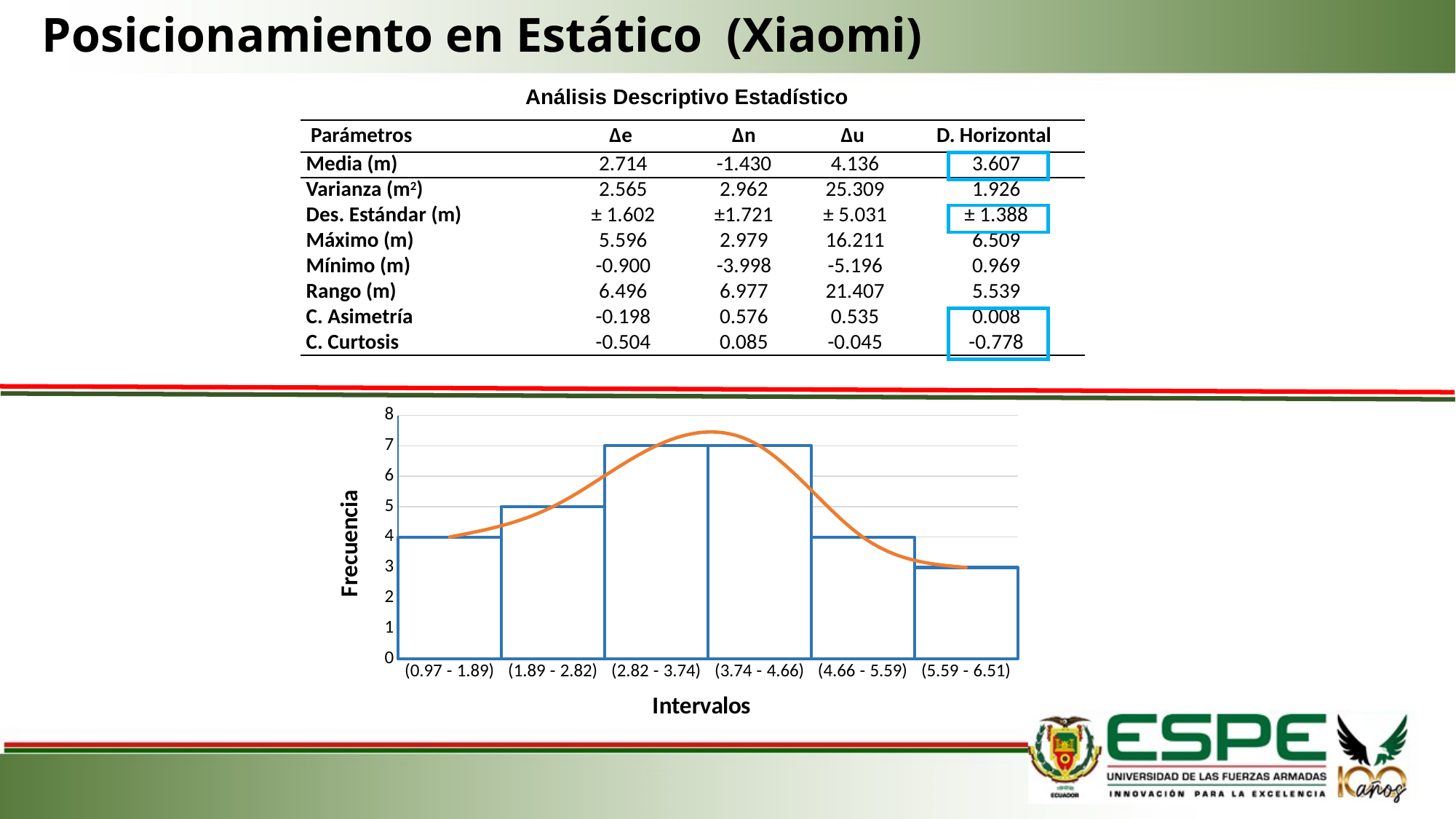
Is the frequency for the interval (3.74 - 4.66) greater or less than 5? greater What is the label of the y axis of the chart? Frecuencia What is the difference in frequency between the intervals (2.82 - 3.74) and (5.59 - 6.51)? 4 What is the frequency for the interval (5.59 - 6.51)? 3 What is the frequency for the interval (1.89 - 2.82)? 5 How many intervals are shown on the x axis of the chart? 6 What kind of chart is shown on the slide? combination bar and line chart Which interval has the lowest frequency? (5.59 - 6.51) What is the label of the x axis of the chart? Intervalos What is the frequency for the interval (2.82 - 3.74)? 7 Which has a higher frequency, the interval (1.89 - 2.82) or the interval (4.66 - 5.59)? (1.89 - 2.82) What is the frequency for the interval (0.97 - 1.89)? 4